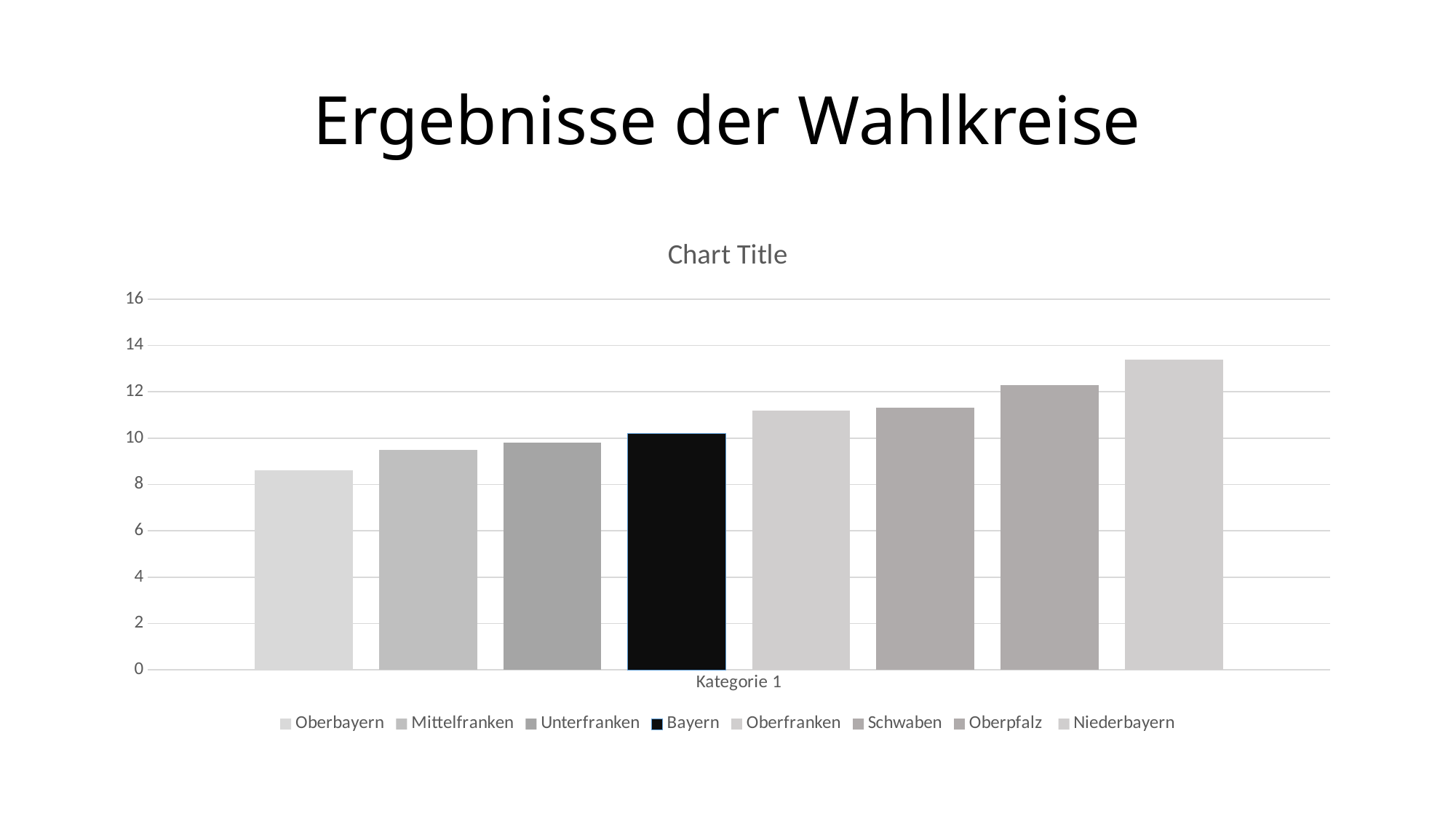
Do the bars rise or fall from left to right? rise What kind of chart is shown on the slide? bar chart Which series is drawn in black? Bayern Which is larger, the value for Oberpfalz or the value for Unterfranken? Oberpfalz Which series has the lowest bar? Oberbayern Which series has the highest bar? Niederbayern Is the value for Niederbayern greater or less than 12? greater How many series does the legend list? 8 How many categories are shown on the x axis? 1 Is the value for Oberbayern greater or less than 10? less Is the value for Mittelfranken greater or less than 10? less